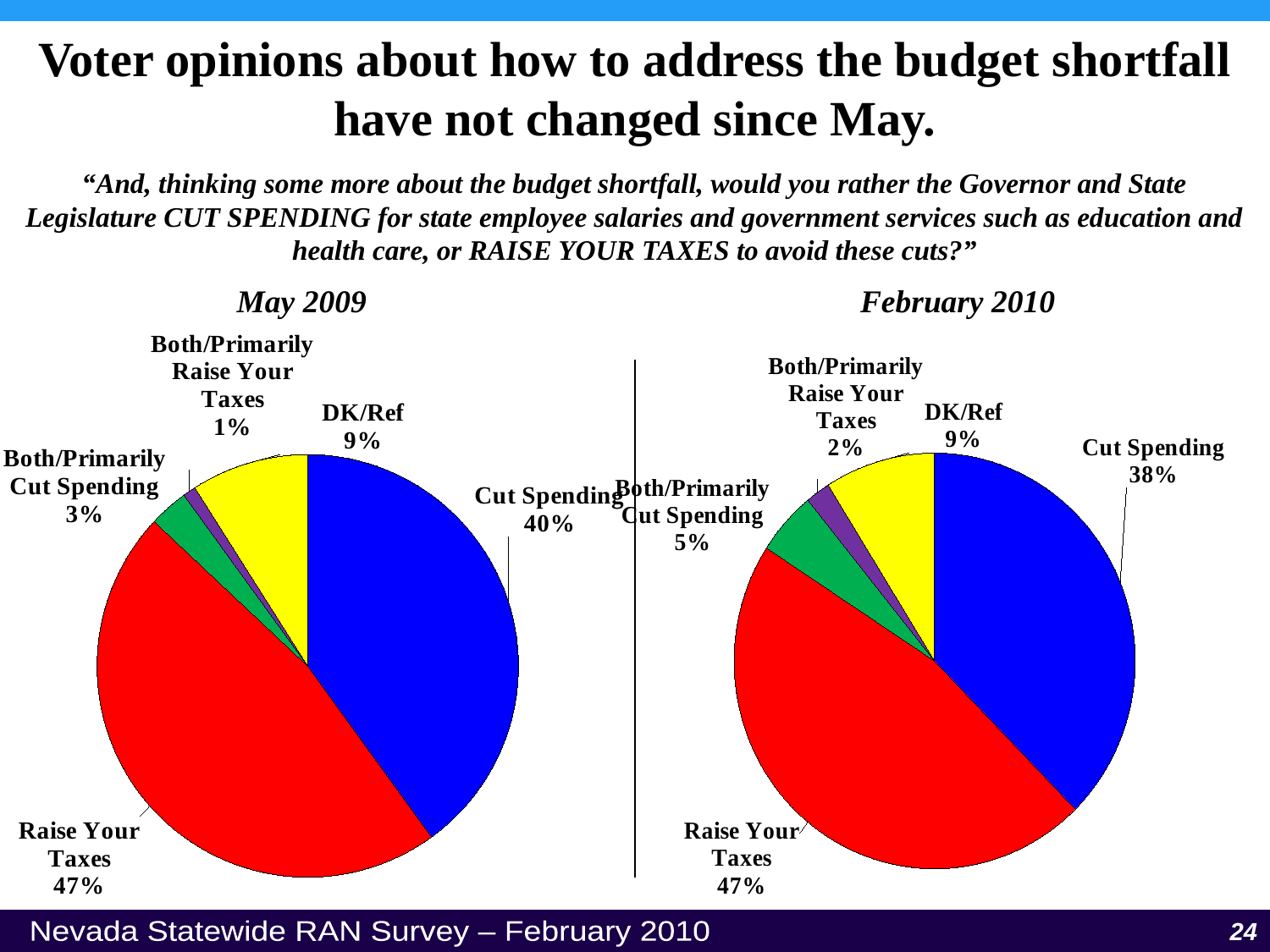
In the May 2009 pie chart, which category has the smallest share? Both/Primarily Raise Your Taxes In the February 2010 pie chart, what share of voters chose Cut Spending? 38% In the February 2010 pie chart, what colour is the Cut Spending slice? Blue In the February 2010 pie chart, which category has the smallest share? Both/Primarily Raise Your Taxes What type of chart is used to show the February 2010 results? Pie chart In the May 2009 pie chart, what is the value for Both/Primarily Cut Spending? 3% In the February 2010 pie chart, what is the value for Both/Primarily Raise Your Taxes? 2% In the May 2009 pie chart, which category has the largest share? Raise Your Taxes What is the difference between Cut Spending in May 2009 and Cut Spending in February 2010? 2% How many slices does the May 2009 pie chart have? 5 In the February 2010 pie chart, which is larger: Raise Your Taxes or Cut Spending? Raise Your Taxes In the May 2009 pie chart, what share of voters chose Raise Your Taxes? 47%